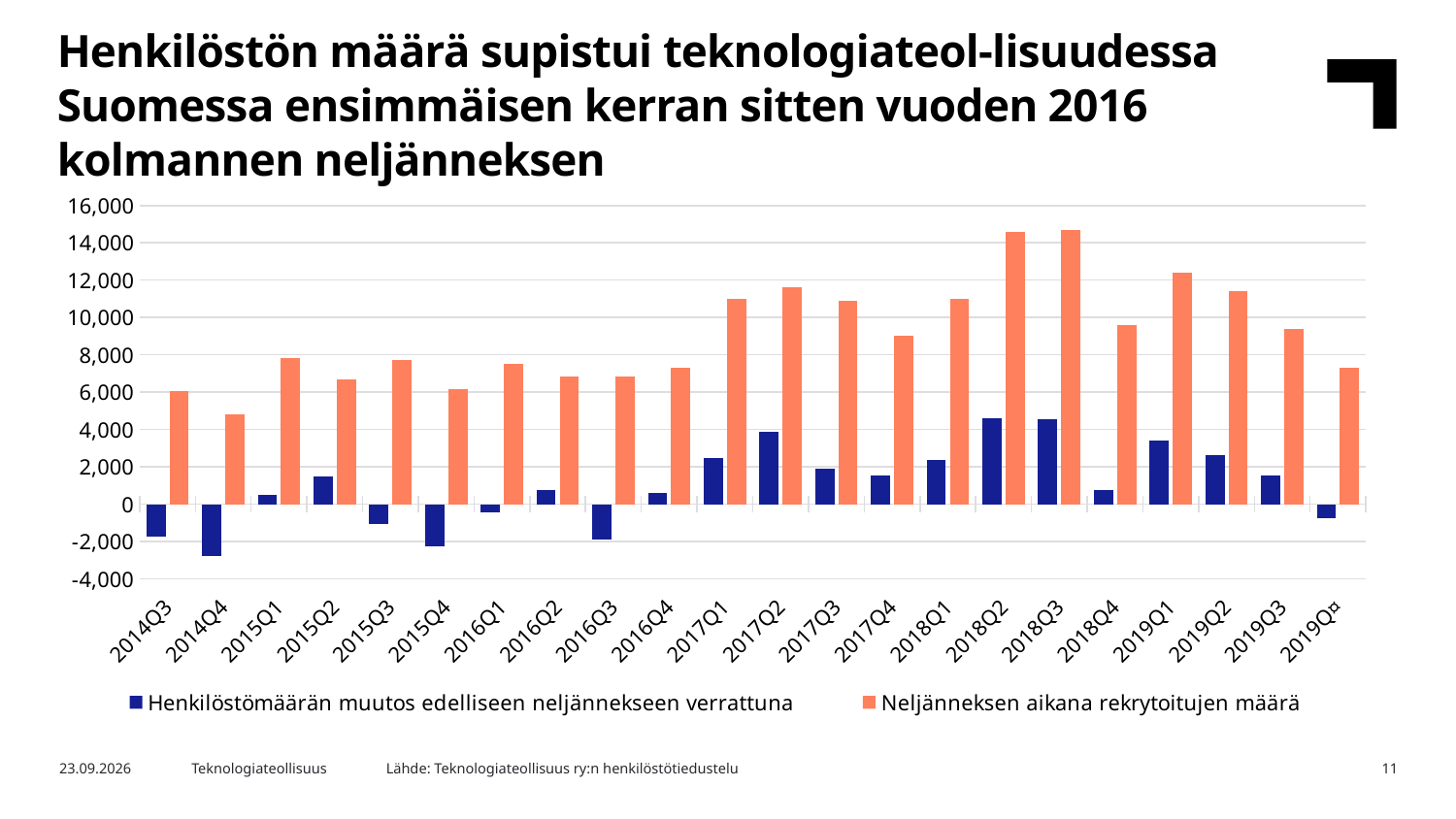
Which quarter has the lowest value for 'Neljänneksen aikana rekrytoitujen määrä'? 2014Q4 How many series does the legend list? 2 How many quarters are shown on the x axis? 22 Which is larger for 'Neljänneksen aikana rekrytoitujen määrä': 2016Q4 or 2017Q1? 2017Q1 Is the value for 'Henkilöstömäärän muutos edelliseen neljännekseen verrattuna' in 2014Q4 greater or less than -2,000? less Is the value for 'Henkilöstömäärän muutos edelliseen neljännekseen verrattuna' in 2017Q2 greater or less than 2,000? greater Is the value for 'Neljänneksen aikana rekrytoitujen määrä' in 2014Q4 greater or less than 6,000? less Which quarter has the lowest value for 'Henkilöstömäärän muutos edelliseen neljännekseen verrattuna'? 2014Q4 What kind of chart is shown on the slide? bar chart Do the values for 'Neljänneksen aikana rekrytoitujen määrä' rise or fall from 2018Q3 to 2019Q4? fall Which colour represents 'Henkilöstömäärän muutos edelliseen neljännekseen verrattuna' in the legend? blue